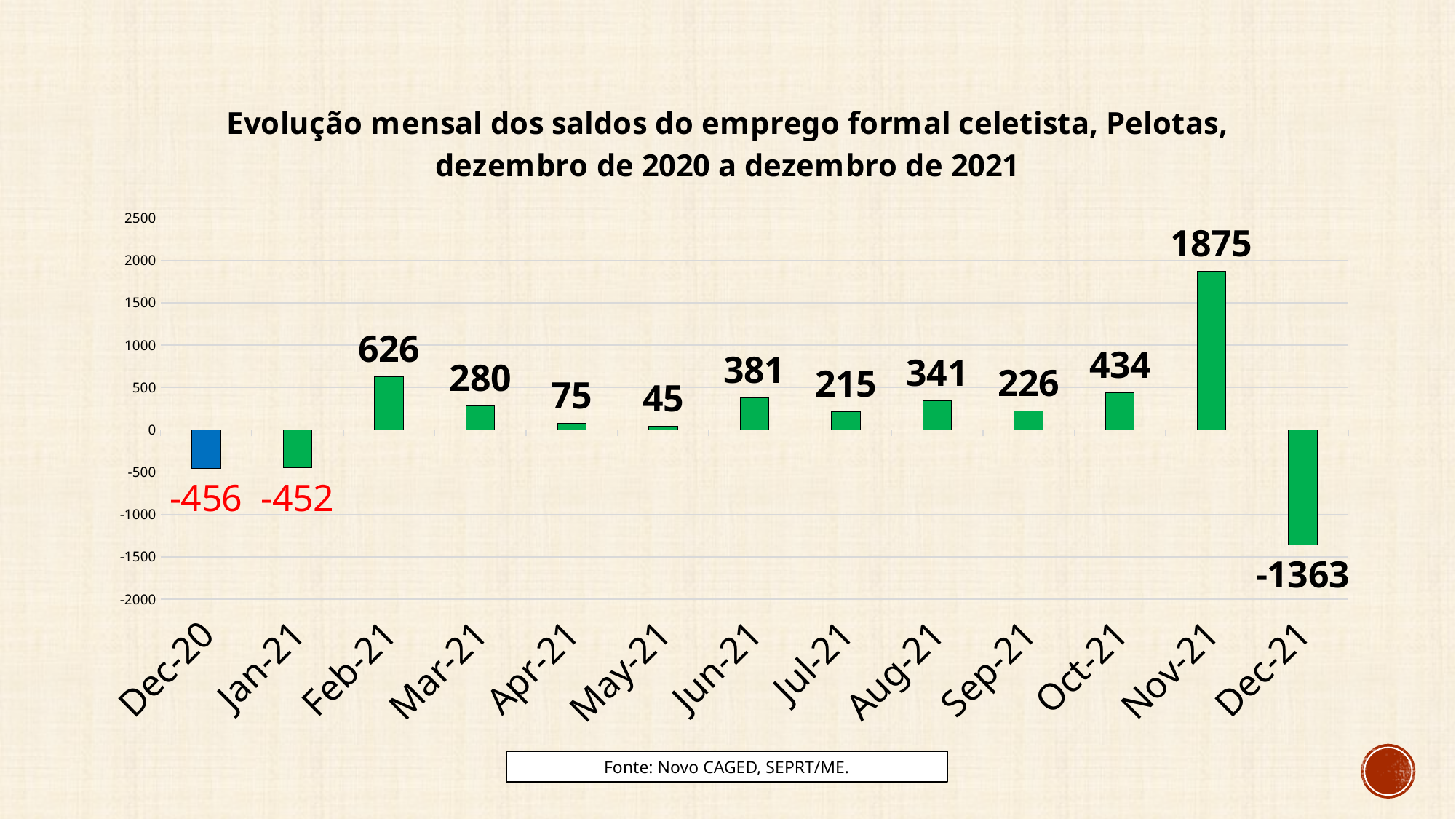
What is the value for Nov-21? 1875 How many months are shown on the x axis? 13 Which bar is coloured blue rather than green? Dec-20 Which month has the lowest value? Dec-21 Which is larger, the value for Jun-21 or the value for Aug-21? Jun-21 What is the difference between the values for Nov-21 and Oct-21? 1441 Which month has the highest value? Nov-21 What is the value for Dec-20? -456 What is the value for Dec-21? -1363 What kind of chart is shown on the slide? Bar chart What is the value for Feb-21? 626 What is the source cited below the chart? Novo CAGED, SEPRT/ME.